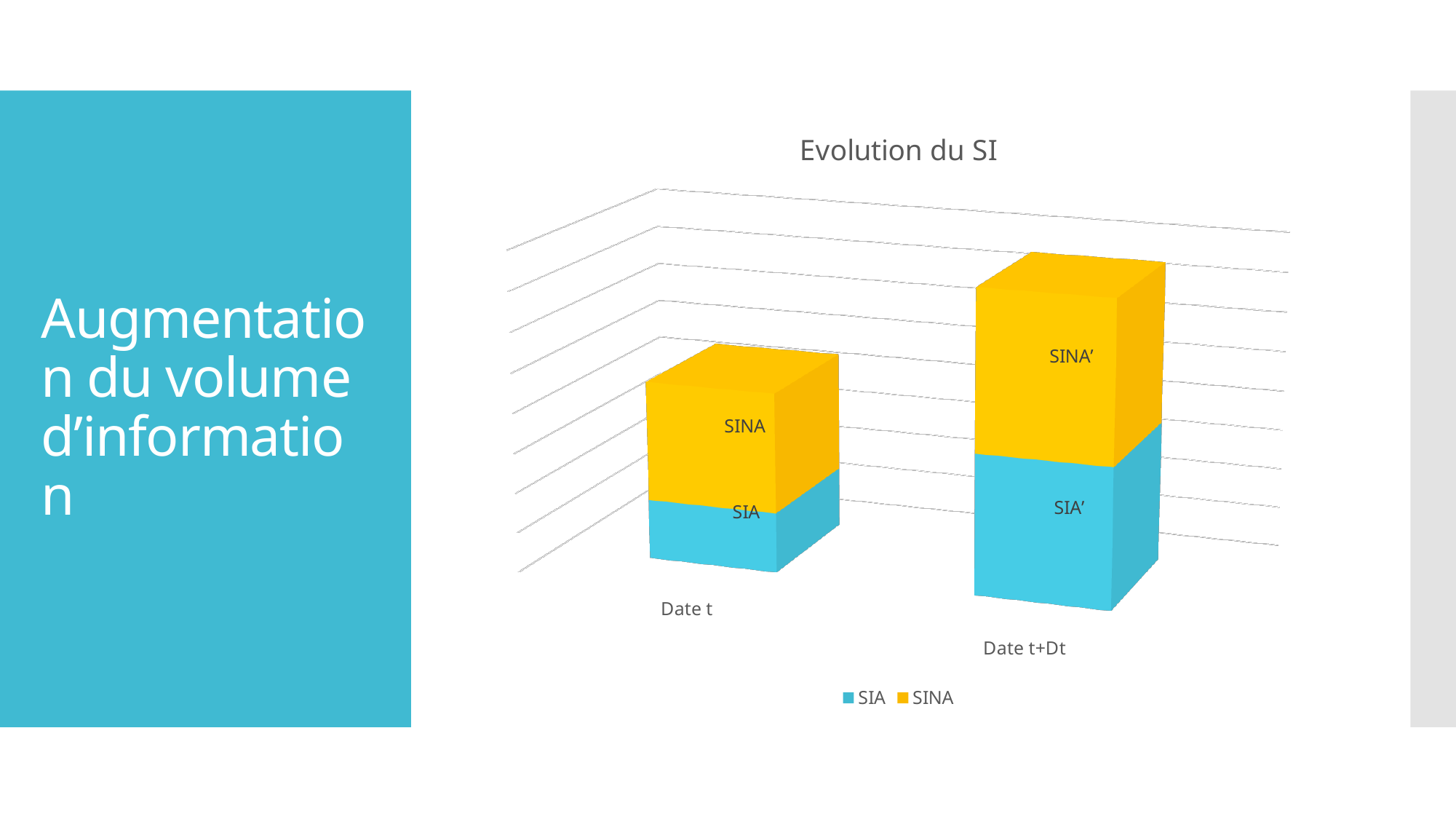
Which series are listed in the chart legend? SIA and SINA Is the SIA segment larger at Date t or at Date t+Dt? Date t+Dt How many series does the chart legend list? 2 Is the SINA segment larger at Date t or at Date t+Dt? Date t+Dt Which category has the tallest stacked bar? Date t+Dt What is the title of the chart? Evolution du SI What label is printed on the blue segment of the Date t+Dt bar? SIA' Does the total height of the stacked bars rise or fall from Date t to Date t+Dt? Rise Which category has the shortest stacked bar? Date t What kind of chart is shown on the slide? Stacked bar chart How many categories are shown on the x axis of the chart? 2 At Date t, which segment is larger, SIA or SINA? SINA